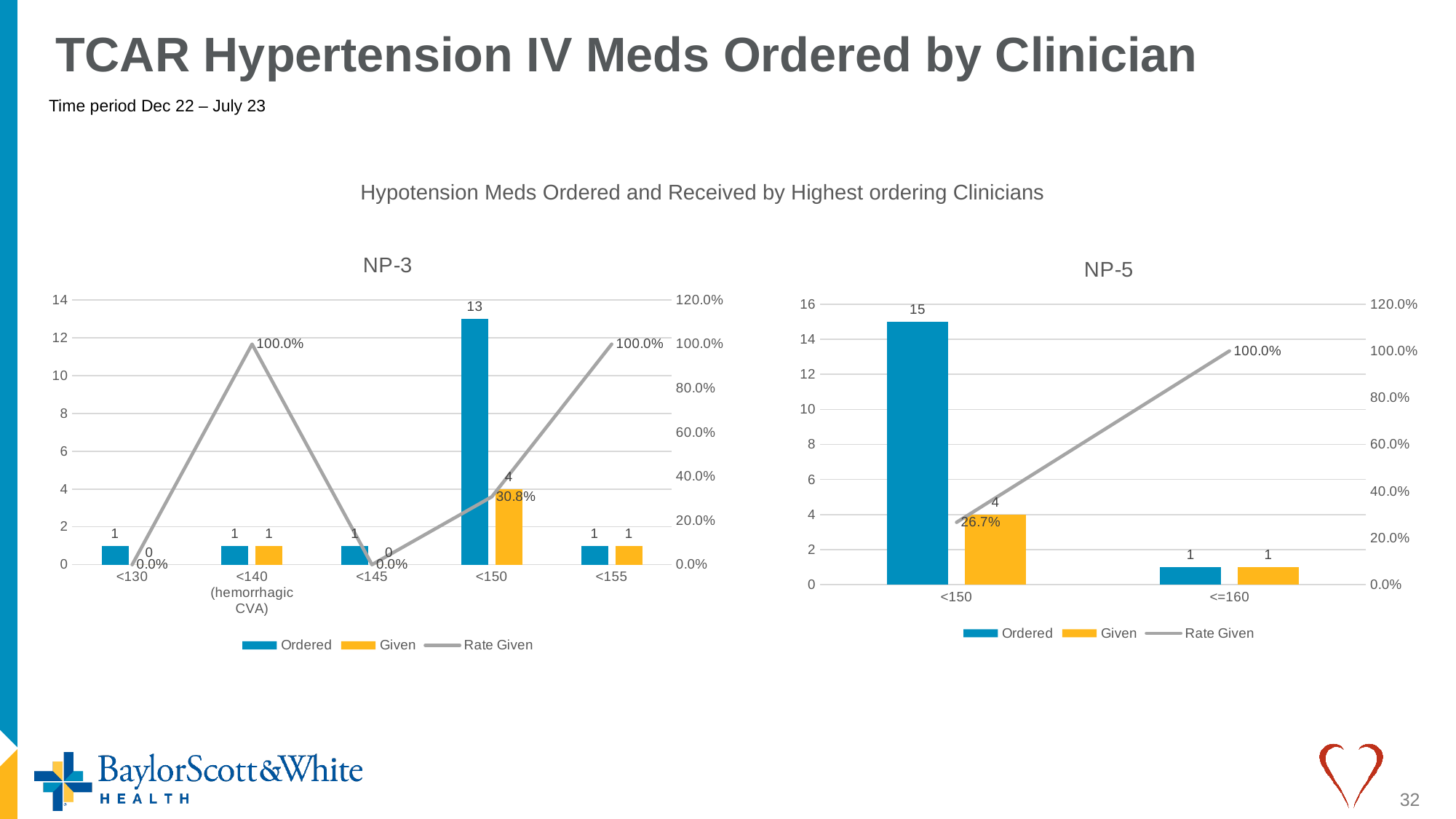
In the NP-3 chart, what is the difference between Ordered and Given for the <150 category? 9 In the NP-5 chart, what is the difference between Ordered and Given for the <150 category? 11 How many series does the legend of the NP-5 chart list? 3 What is the title of the NP-3 chart's right-hand neighbour chart? NP-5 In the NP-5 chart, which category has the higher Rate Given, <150 or <=160? <=160 In the NP-5 chart, what is the Ordered value for the <150 category? 15 In the NP-3 chart, what is the Given value for the <145 category? 0 In the NP-5 chart, what is the Rate Given for the <150 category? 26.7% In the NP-3 chart, what is the Rate Given for the <150 category? 30.8% In the NP-3 chart, which category has the highest Ordered value? <150 In the NP-3 chart, what is the Ordered value for the <150 category? 13 In the NP-3 chart, how many categories are shown on the x axis? 5